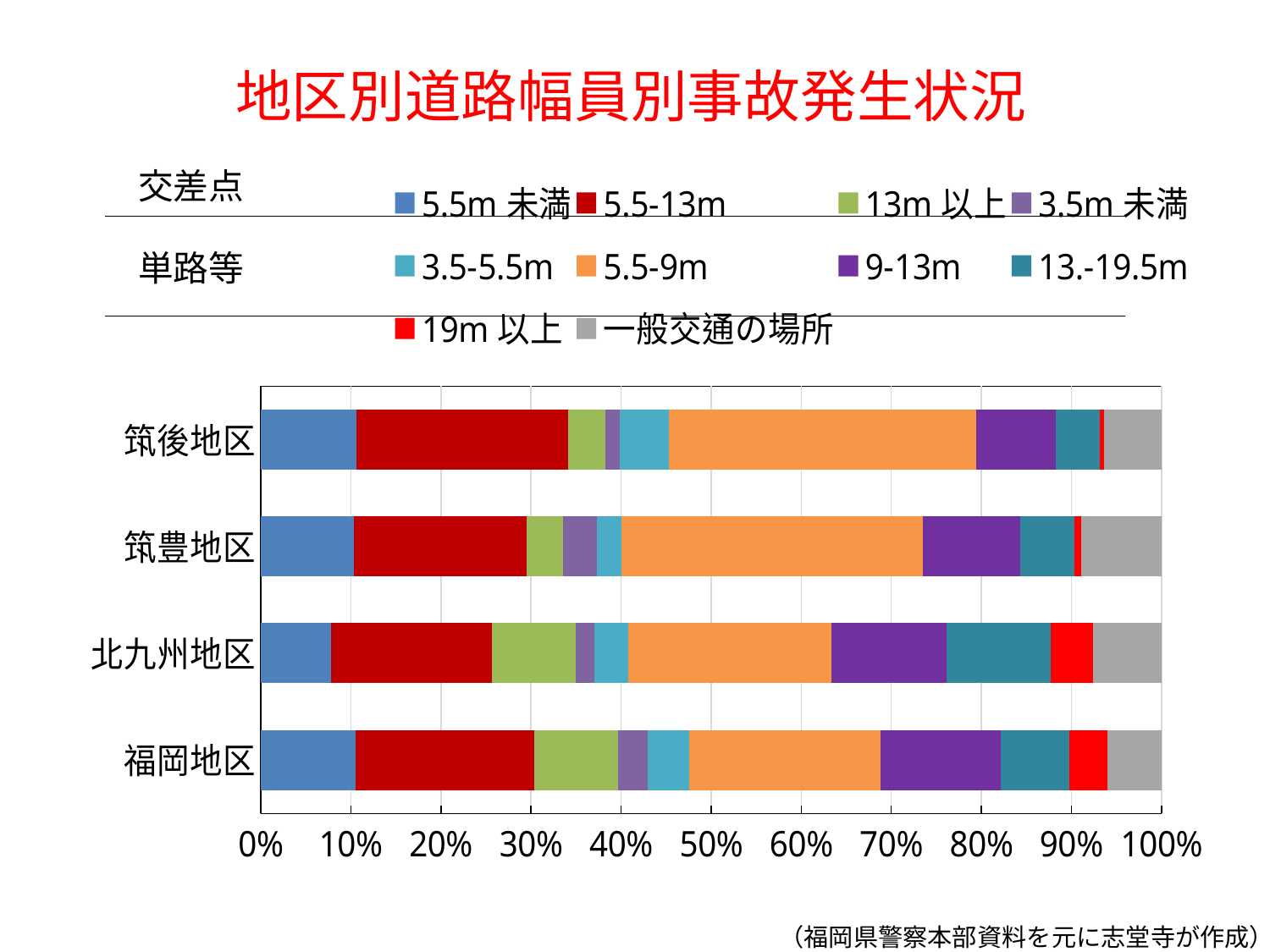
Which legend entry is shown in grey? 一般交通の場所 Which region has the larger 19m 以上 segment, 北九州地区 or 筑後地区? 北九州地区 Which region has the larger 5.5-9m segment, 筑後地区 or 福岡地区? 筑後地区 Is the 5.5m 未満 share for 北九州地区 greater or less than 10%? less What kind of chart is shown on the slide? Stacked bar chart How many series does the legend list? 10 How many regions (categories) are plotted on the chart? 4 Is the 5.5-9m share for 筑後地区 greater or less than 30%? greater Which region has the larger 13m 以上 segment, 福岡地区 or 筑後地区? 福岡地区 Is the 5.5-13m share for 筑後地区 greater or less than 20%? greater What is the title of the chart? 地区別道路幅員別事故発生状況